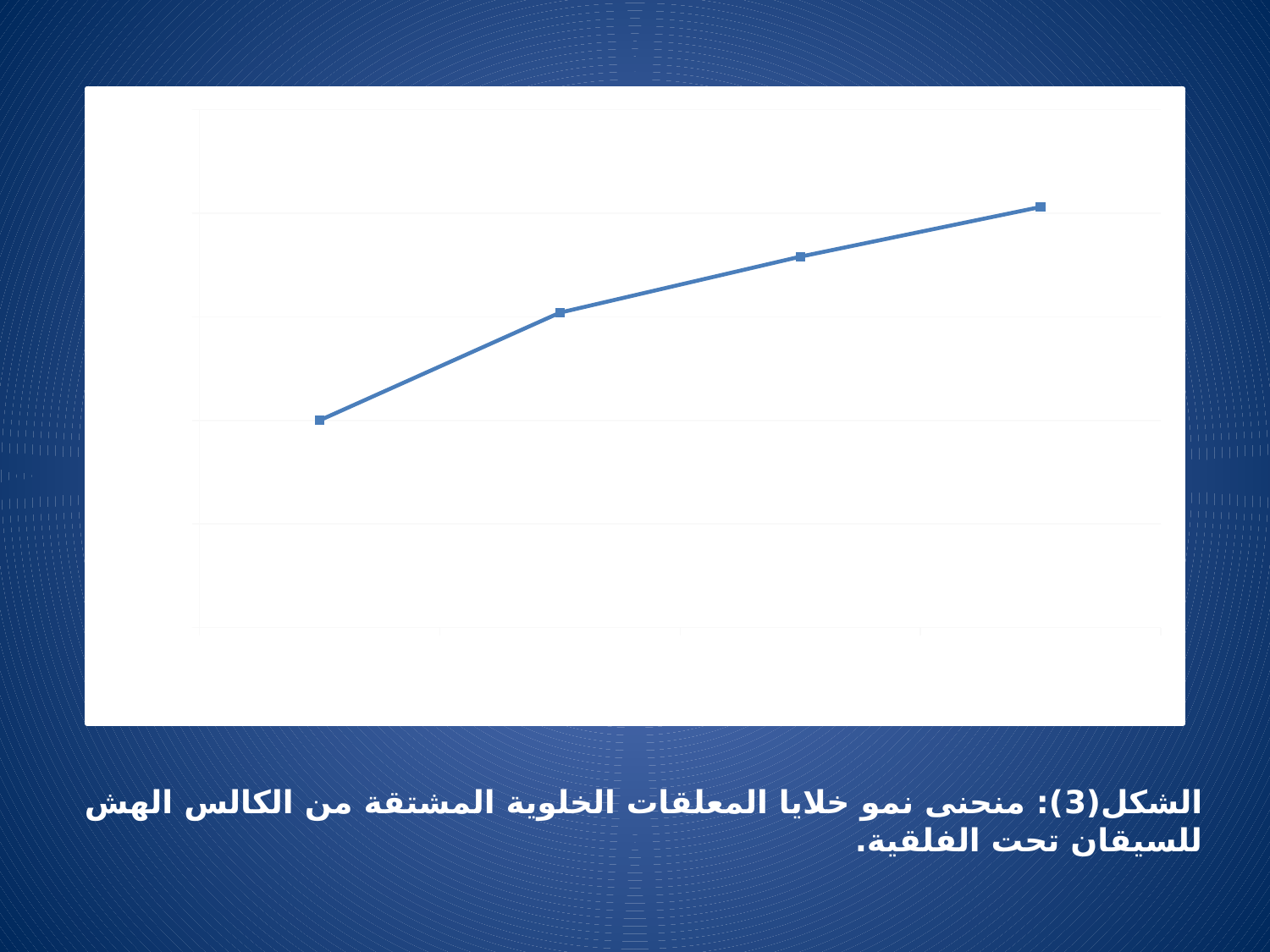
Is the third point from the left higher or lower than the fourth point? lower How many lines (series) are plotted on the chart? 1 What kind of chart is shown on the slide? line chart What colour is the plotted line? blue How many data points are plotted on the line? 4 Which plotted point is the lowest: the first (leftmost) or the last (rightmost)? the first (leftmost) Is the second point from the left higher or lower than the first point? higher Which plotted point is the highest: the first (leftmost) or the last (rightmost)? the last (rightmost) Do the values rise or fall from left to right along the x axis? rise Does the chart display a legend? No